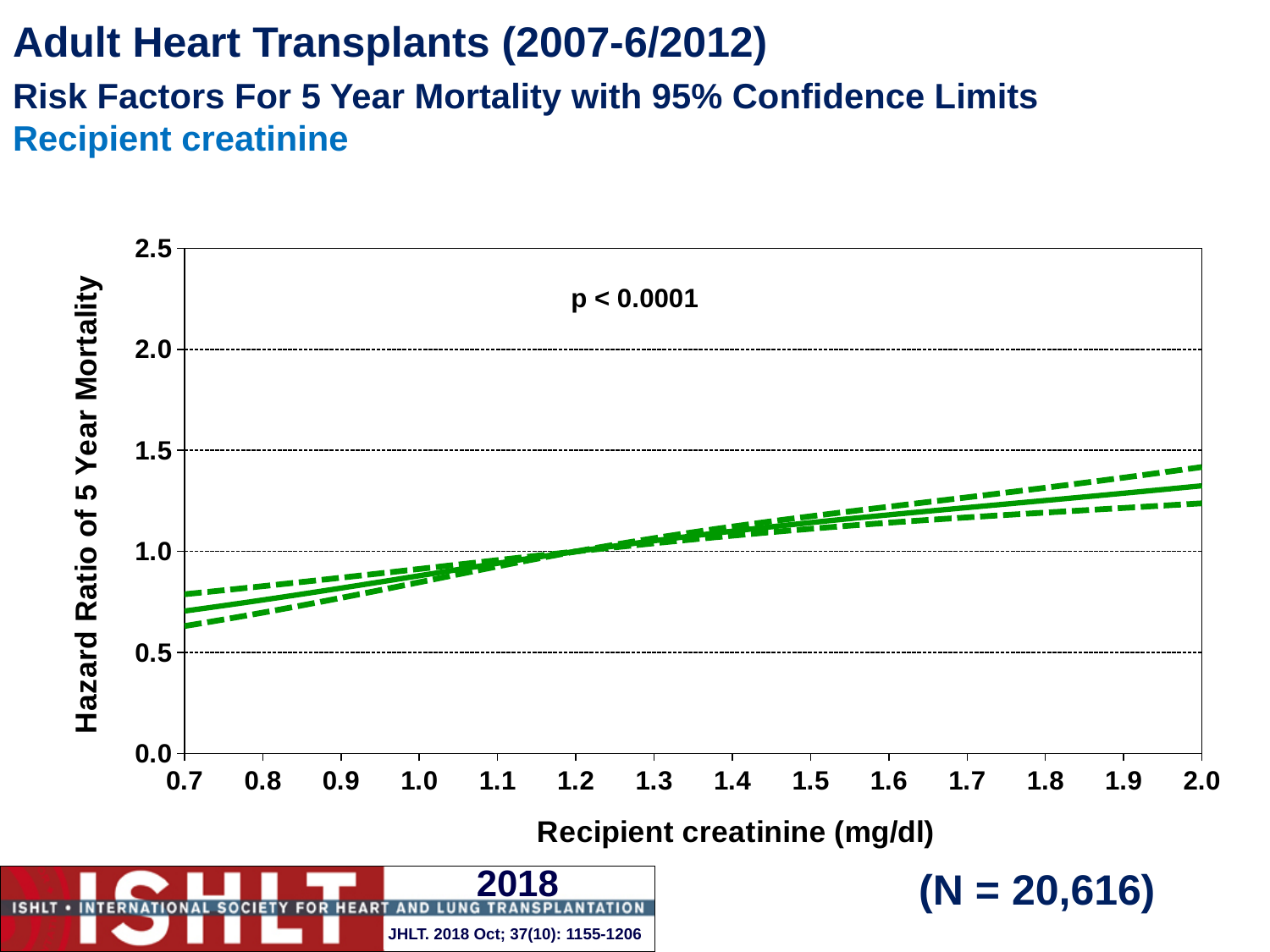
Is the hazard ratio of 5 year mortality at a recipient creatinine of 2.0 mg/dl greater or less than 1.0? greater How many tick labels are shown on the x axis of the chart? 14 Does the hazard ratio of 5 year mortality rise or fall as recipient creatinine increases from 0.7 to 2.0 mg/dl? Rise What kind of chart is shown on the slide? Line chart Is the hazard ratio of 5 year mortality at a recipient creatinine of 0.7 mg/dl greater or less than 1.0? less Which has the higher hazard ratio of 5 year mortality: a recipient creatinine of 0.8 mg/dl or 1.8 mg/dl? 1.8 mg/dl What is the highest value shown on the y axis of the chart? 2.5 What p-value is printed on the chart? p < 0.0001 What is the label of the y axis of the chart? Hazard Ratio of 5 Year Mortality Is the hazard ratio of 5 year mortality at a recipient creatinine of 2.0 mg/dl greater or less than 1.5? less